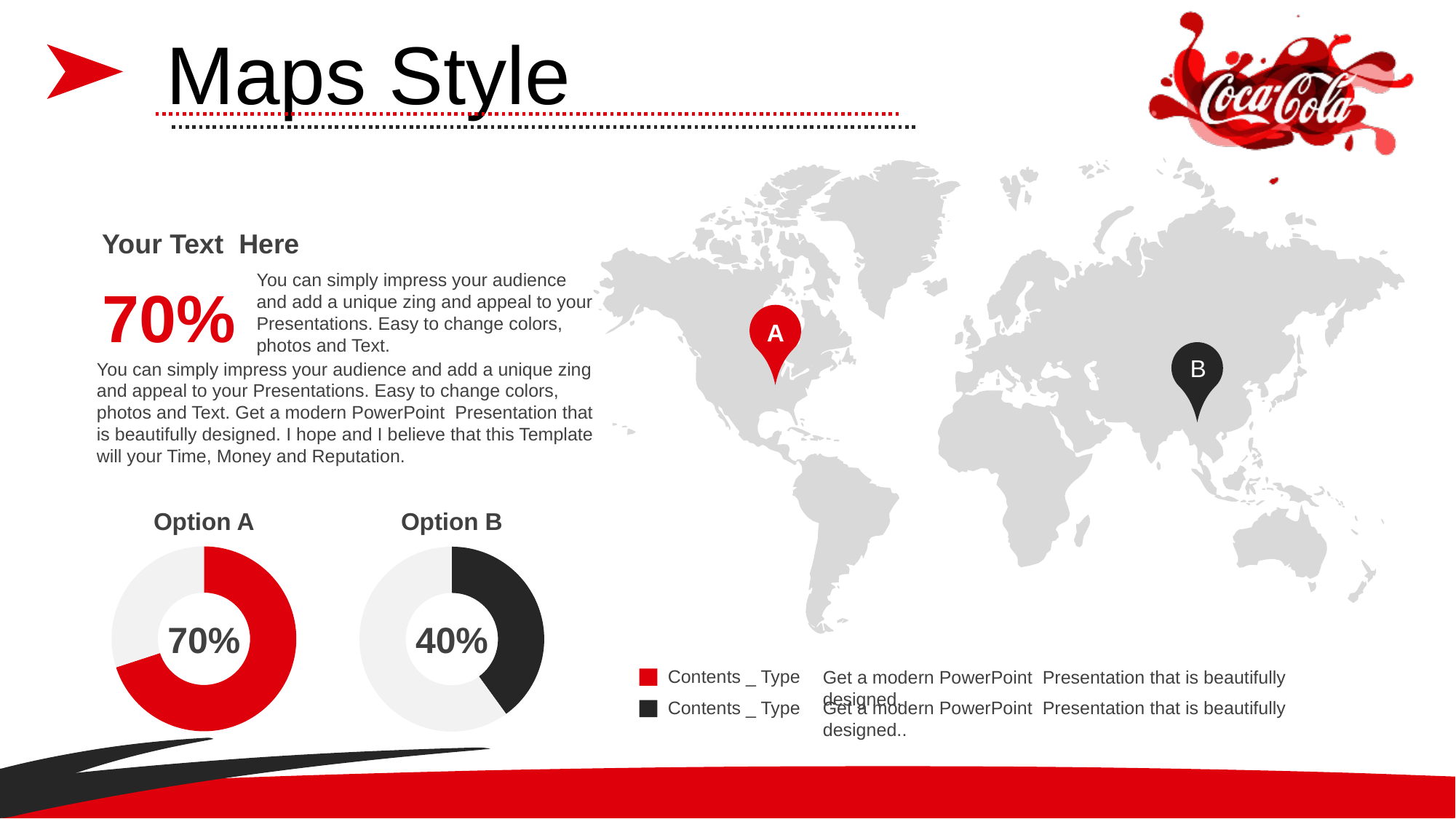
What percentage is shown in the centre of the Option B donut chart? 40% Which option has the higher percentage, Option A or Option B? Option A What kind of chart is used for Option A and Option B? Donut (pie) chart In the Option A donut chart, what share of the ring is filled by the red slice? 70% In the Option B donut chart, what share of the ring is filled by the black slice? 40% What percentage is shown in the centre of the Option A donut chart? 70% What colour is the filled portion of the Option A donut chart? Red Which of the two donut charts shows the highest percentage? Option A How many donut charts are shown on the slide? 2 What is the difference between the Option A percentage and the Option B percentage? 30% Which of the two donut charts shows the lowest percentage? Option B What colour is the filled portion of the Option B donut chart? Black